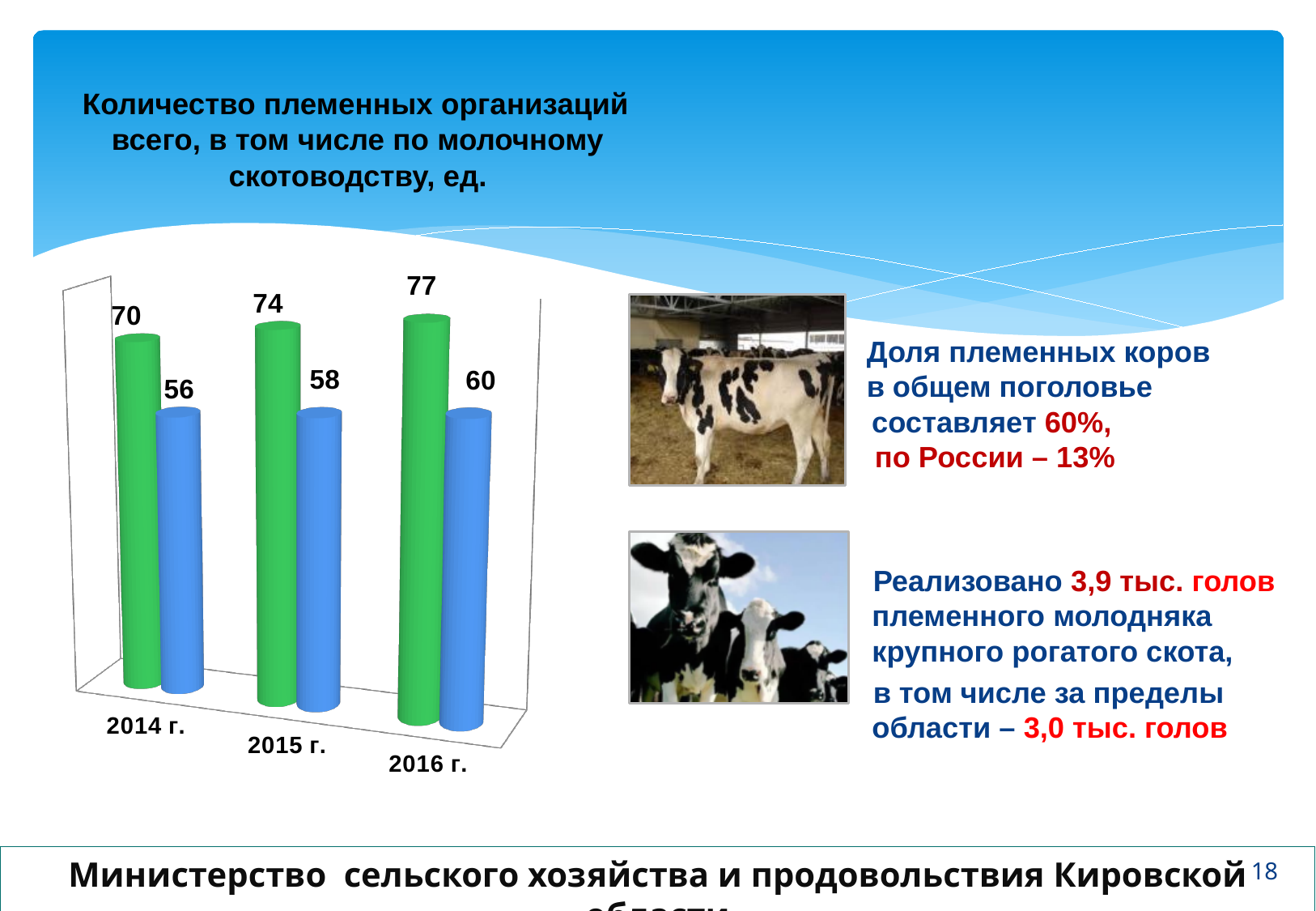
What type of chart is shown on the slide? bar chart What is the value of the blue bar for 2015 г.? 58 By how much did the green bar increase from 2014 г. to 2016 г.? 7 In which year is the blue bar lowest? 2014 г. What is the difference between the green and blue bars for 2015 г.? 16 Do the blue bar values rise or fall from 2014 г. to 2016 г.? rise What is the value of the green bar for 2014 г.? 70 How many years are shown on the x axis of the chart? 3 Which is larger, the blue bar for 2016 г. or the green bar for 2014 г.? the green bar for 2014 г. What is the value of the blue bar for 2016 г.? 60 What is the value of the green bar for 2016 г.? 77 In which year is the green bar highest? 2016 г.